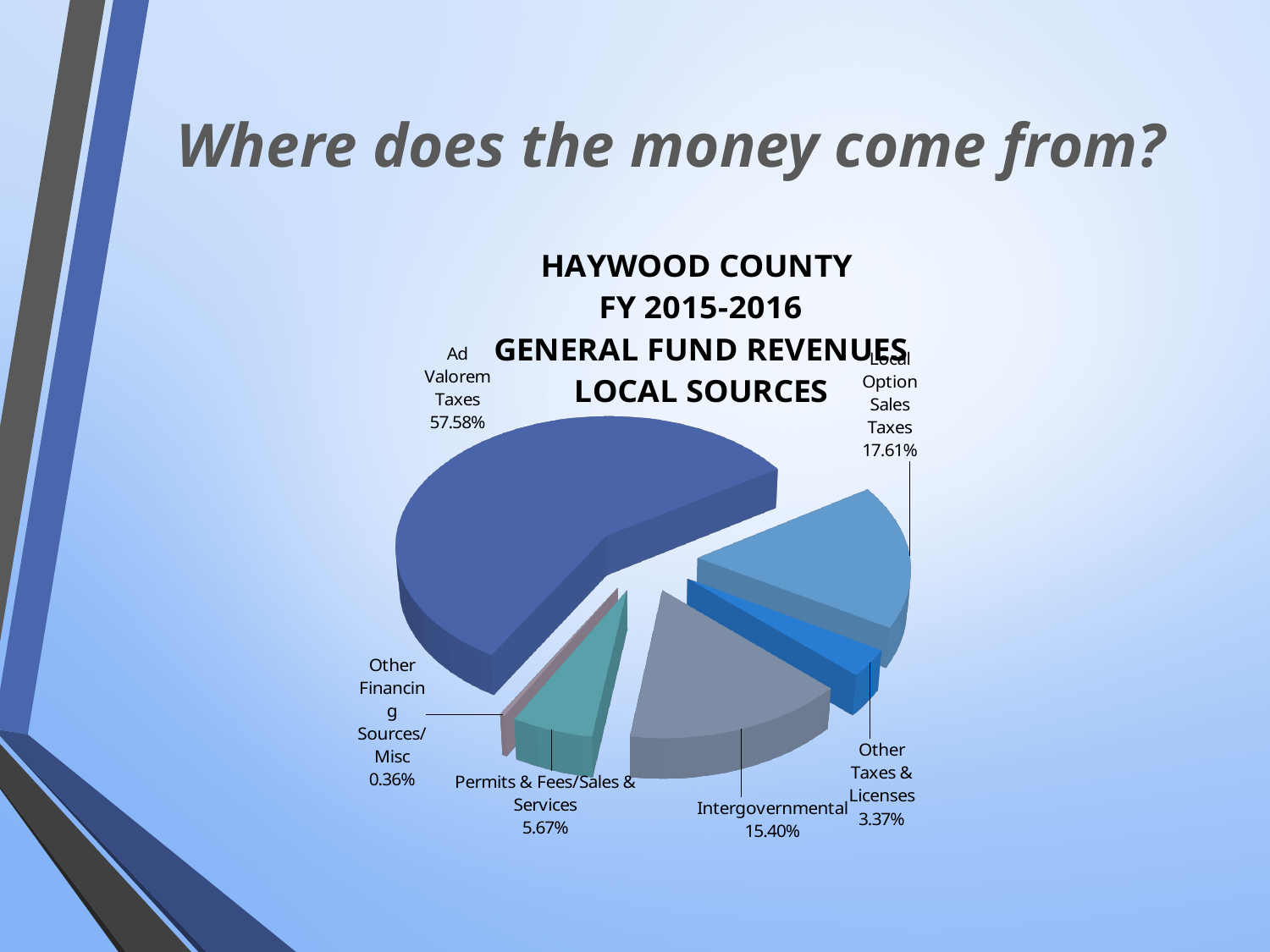
What kind of chart is shown on the slide? Pie chart What fiscal year is named in the chart title? FY 2015-2016 What is the value shown for Intergovernmental? 15.40% What is the value shown for Other Taxes & Licenses? 3.37% How many slices does the pie chart have? 6 Which category has the smallest share of the pie? Other Financing Sources/Misc What is the value shown for Local Option Sales Taxes? 17.61% What is the difference between the shares of Local Option Sales Taxes and Intergovernmental? 2.21% Which is larger, Permits & Fees/Sales & Services or Other Taxes & Licenses? Permits & Fees/Sales & Services What is the value shown for Permits & Fees/Sales & Services? 5.67% What share of the pie does Ad Valorem Taxes represent? 57.58% Which category has the largest share of the pie? Ad Valorem Taxes